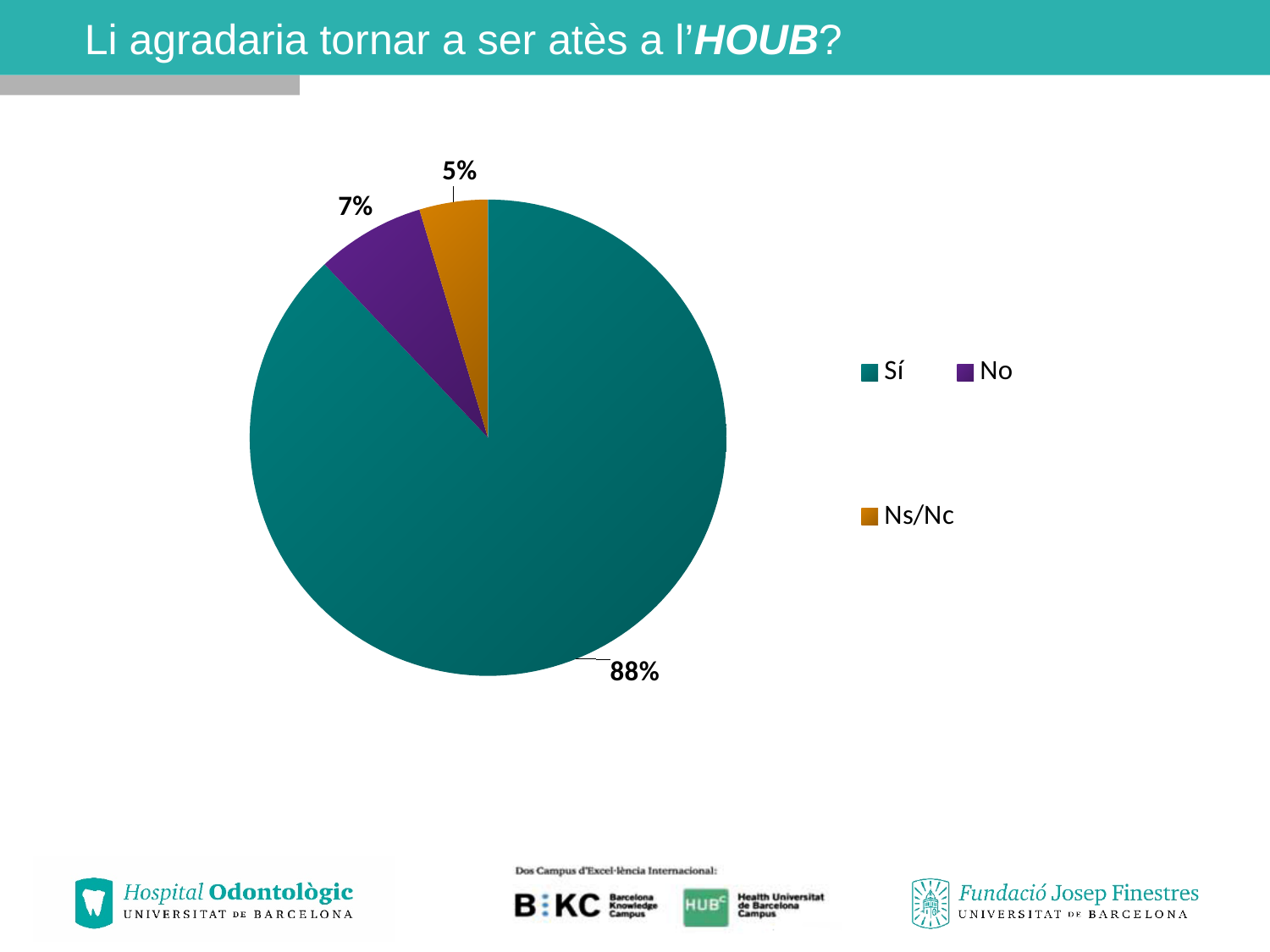
How many slices does the pie chart have? 3 Which category has the smallest slice of the pie? Ns/Nc How many entries does the legend list? 3 What share of the pie does the Sí slice represent? 88% What colour is the Sí slice of the pie? teal Which is larger, the No slice or the Ns/Nc slice? No What share of the pie does the Ns/Nc slice represent? 5% What share of the pie does the No slice represent? 7% Which category has the largest slice of the pie? Sí What is the difference in percentage points between the Sí slice and the No slice? 81 What kind of chart is shown on the slide? pie chart What is the difference in percentage points between the No slice and the Ns/Nc slice? 2